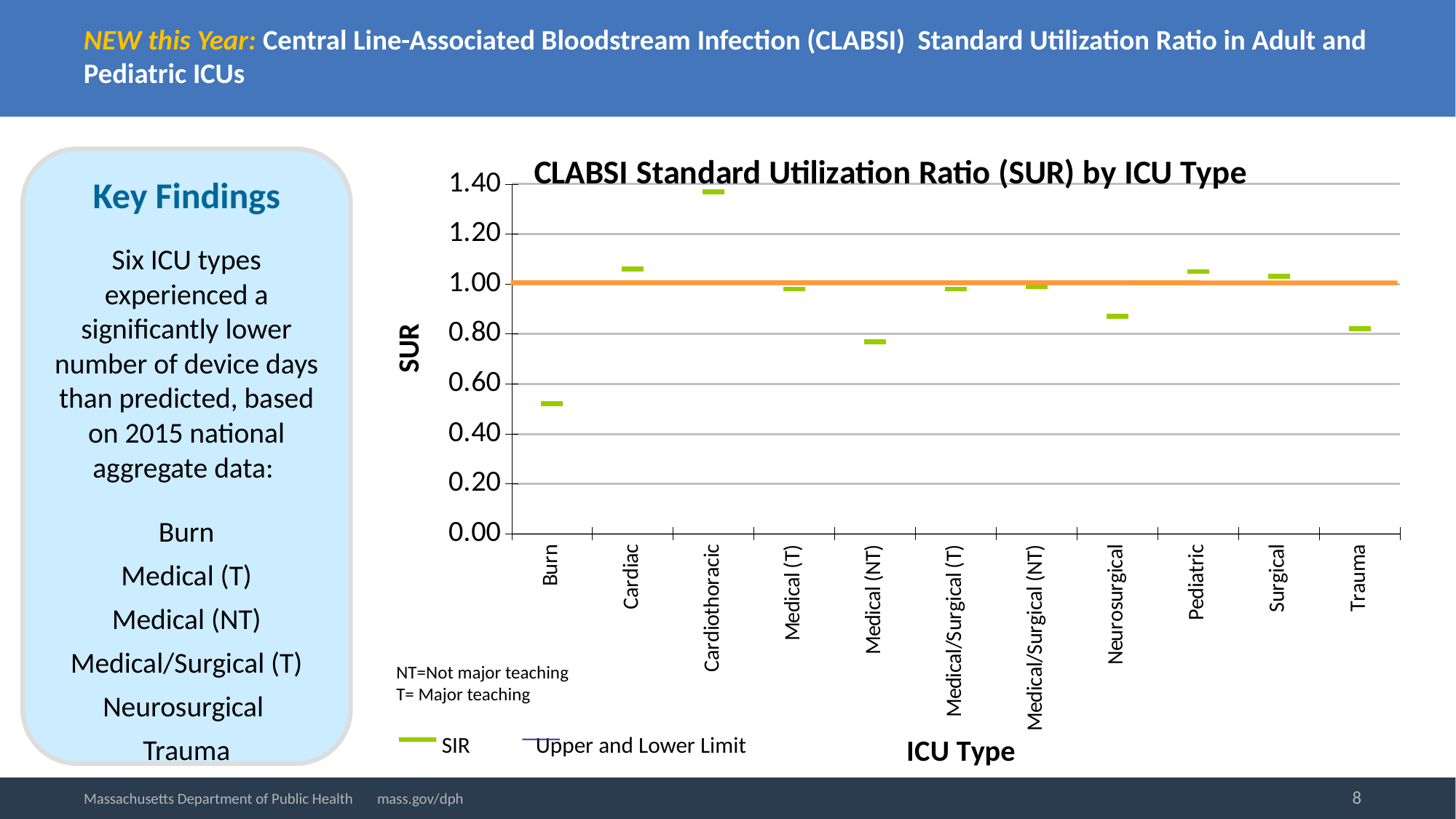
How many ICU types are shown on the x axis of the chart? 11 Which ICU type has the lowest SUR in the chart? Burn Is the SUR value for Burn greater or less than 0.60? less What is the title of the chart? CLABSI Standard Utilization Ratio (SUR) by ICU Type Which has a higher SUR, Medical (NT) or Neurosurgical? Neurosurgical What is the label on the vertical axis of the chart? SUR Is the SUR value for Medical (NT) greater or less than 0.80? less Which ICU type has the highest SUR in the chart? Cardiothoracic Is the SUR value for Cardiothoracic greater or less than 1.20? greater Which has a higher SUR, Burn or Cardiothoracic? Cardiothoracic How many series does the chart legend list? 2